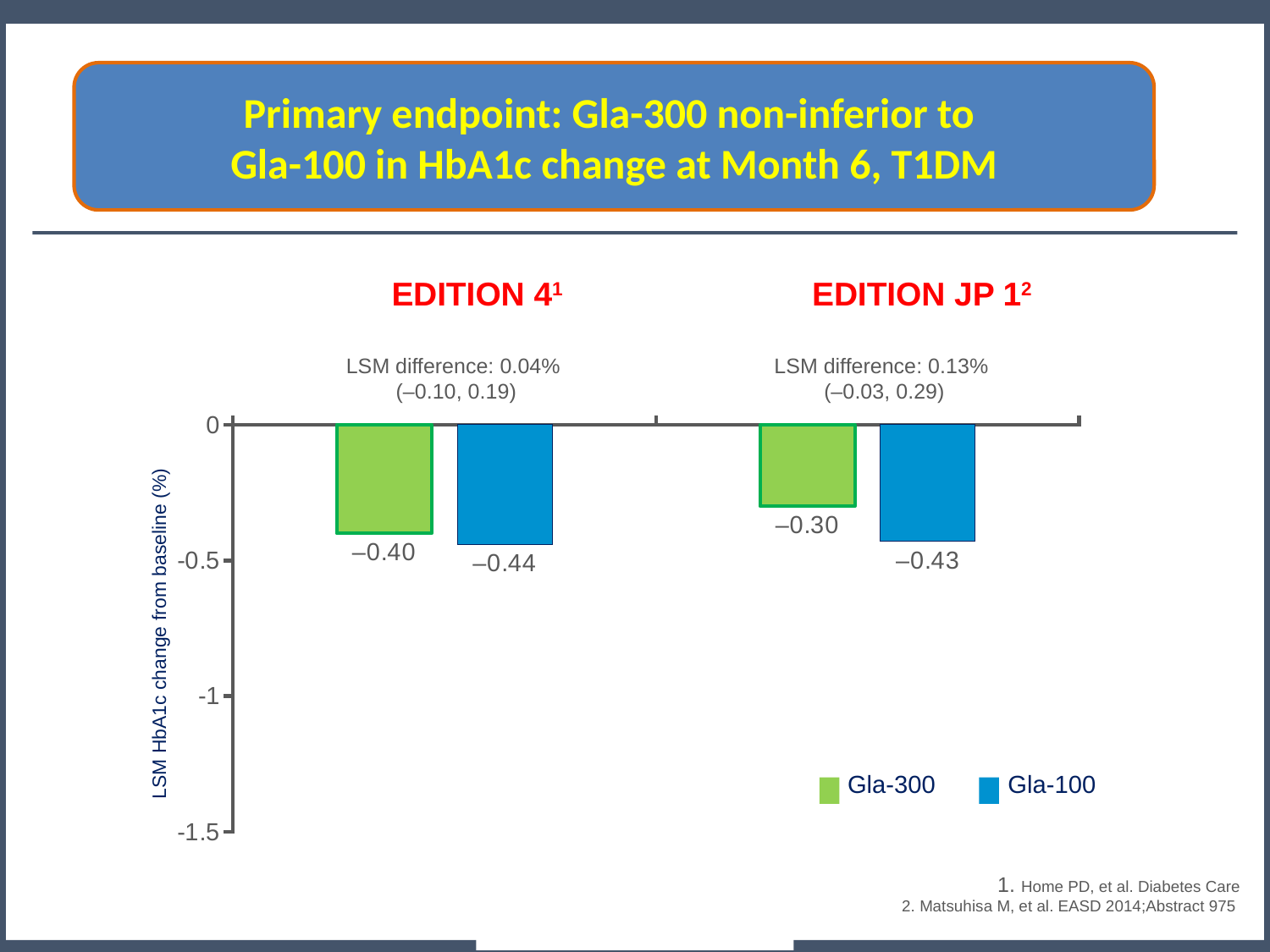
Which bar shows the smallest reduction in HbA1c from baseline? Gla-300 in EDITION JP 1 What is the LSM HbA1c change from baseline for Gla-100 in EDITION JP 1? –0.43 What is the difference between the Gla-300 and Gla-100 HbA1c changes in EDITION JP 1? 0.13 What is the LSM HbA1c change from baseline for Gla-300 in EDITION 4? –0.40 What is the LSM HbA1c change from baseline for Gla-100 in EDITION 4? –0.44 What kind of chart is shown on the slide? Bar chart What is the LSM HbA1c change from baseline for Gla-300 in EDITION JP 1? –0.30 What is the LSM difference reported for EDITION 4? 0.04% (–0.10, 0.19) Which colour represents Gla-300 in the chart? Green Which bar shows the largest reduction in HbA1c from baseline? Gla-100 in EDITION 4 How many series does the legend list? 2 In EDITION 4, which treatment shows a larger HbA1c reduction, Gla-300 or Gla-100? Gla-100